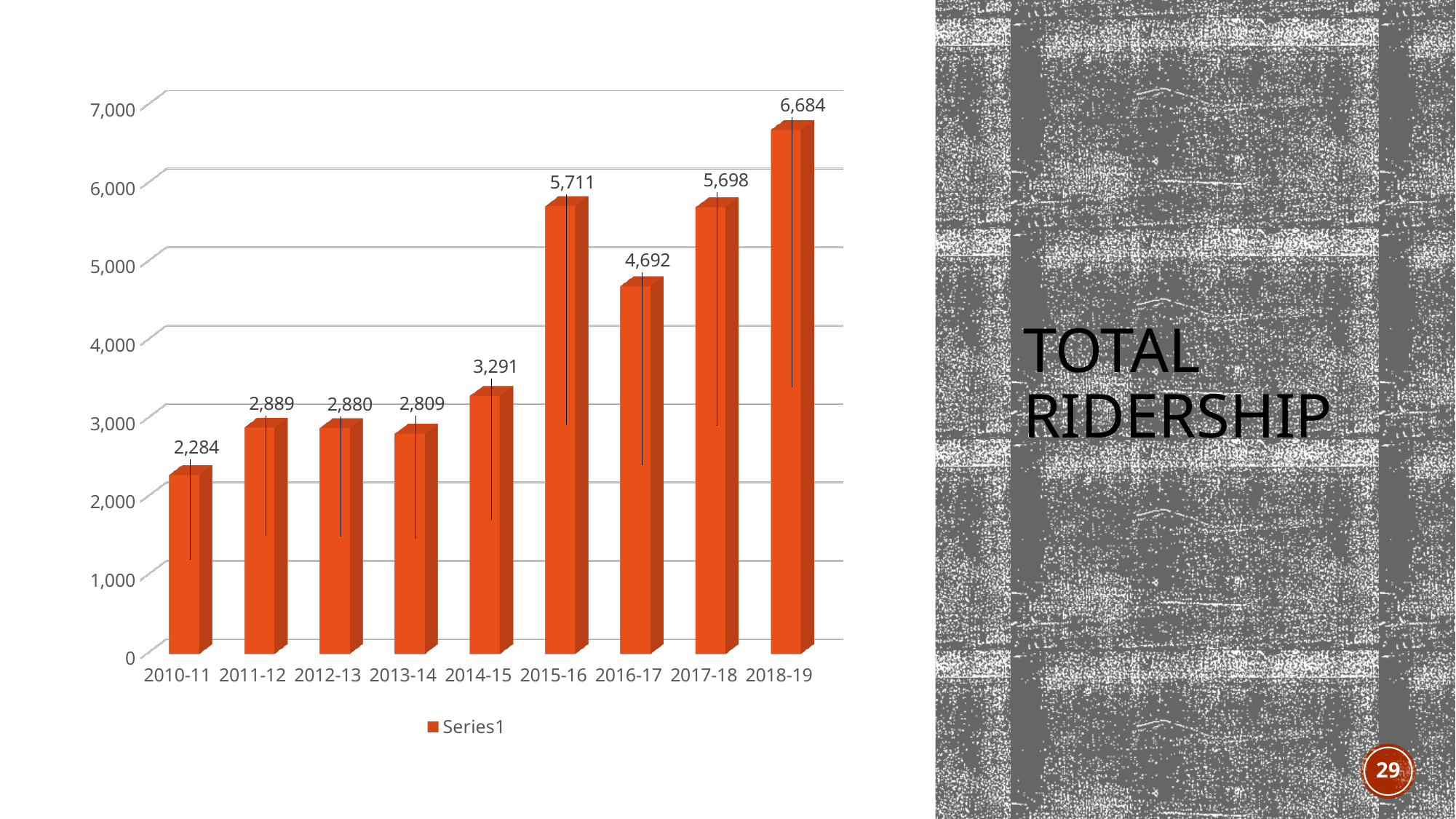
Which is larger, the value for 2015-16 or the value for 2016-17? 2015-16 How many years are shown on the x axis? 9 Which year has the lowest value? 2010-11 What is the value for 2014-15? 3,291 What is the difference between the values for 2018-19 and 2017-18? 986 Is the value for 2013-14 greater or less than 3,000? less What is the title of the slide? TOTAL RIDERSHIP What kind of chart is shown on the slide? bar chart What is the value for 2016-17? 4,692 What is the value for 2010-11? 2,284 What is the difference between the values for 2015-16 and 2014-15? 2,420 Which year has the highest value? 2018-19